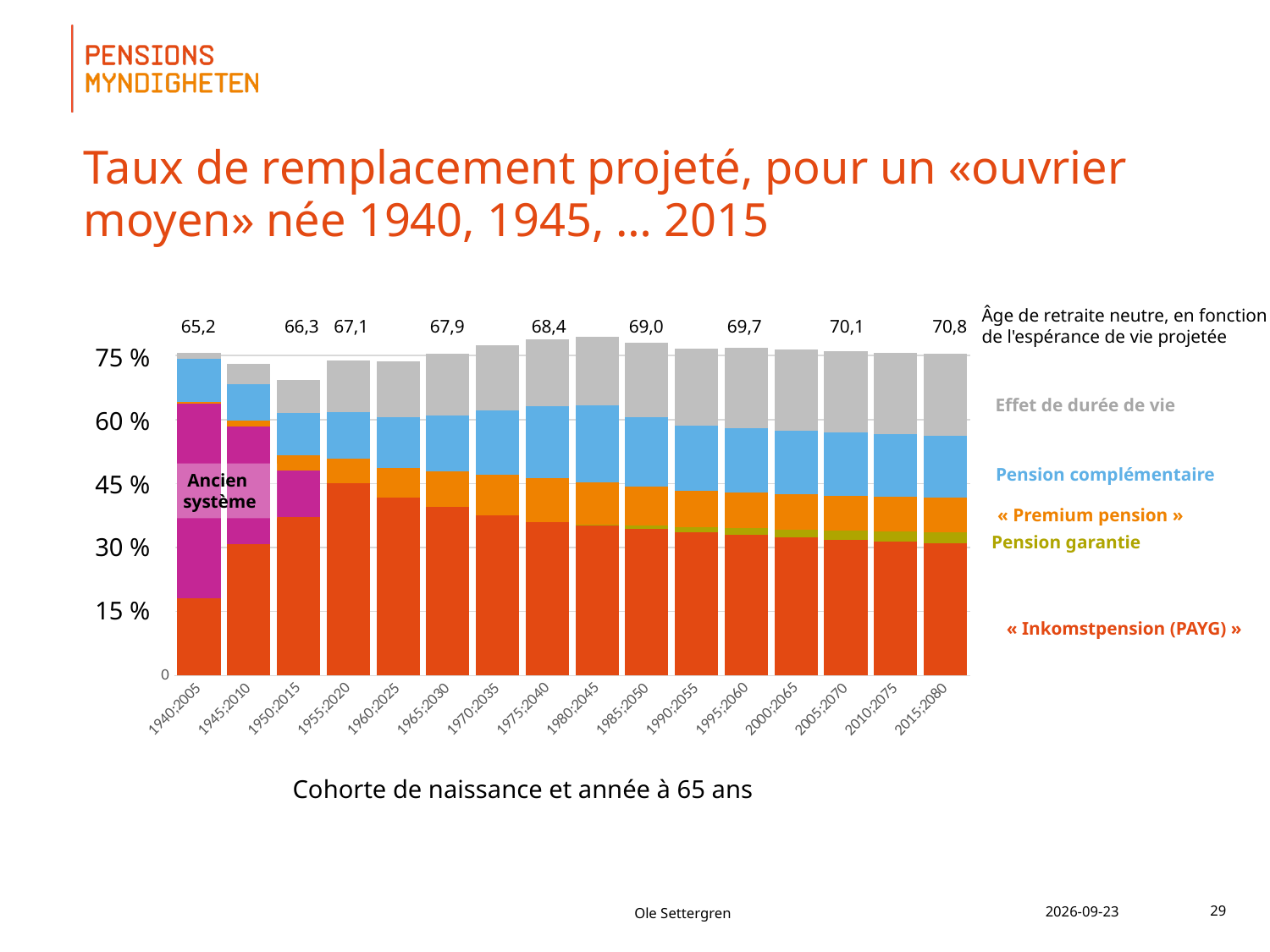
What neutral retirement age is printed above the 1940;2005 bar? 65,2 What kind of chart is shown on the slide? Stacked bar chart Is the total replacement rate for the 1950;2015 cohort greater or less than 75 %? less Which cohort has the larger « Inkomstpension (PAYG) » segment, 1940;2005 or 1955;2020? 1955;2020 From the 1955;2020 cohort to the 2015;2080 cohort, does the « Inkomstpension (PAYG) » segment rise or fall? Fall Is the total replacement rate for the 1980;2045 cohort greater or less than 75 %? greater What neutral retirement age is printed above the 2015;2080 bar? 70,8 Which cohort has the lowest total projected replacement rate? 1950;2015 What neutral retirement age is printed above the 1985;2050 bar? 69,0 What is the x-axis title of the chart? Cohorte de naissance et année à 65 ans How many birth cohorts (bars) are shown on the x axis? 16 Is the « Inkomstpension (PAYG) » share for the 1955;2020 cohort greater or less than 30 %? greater